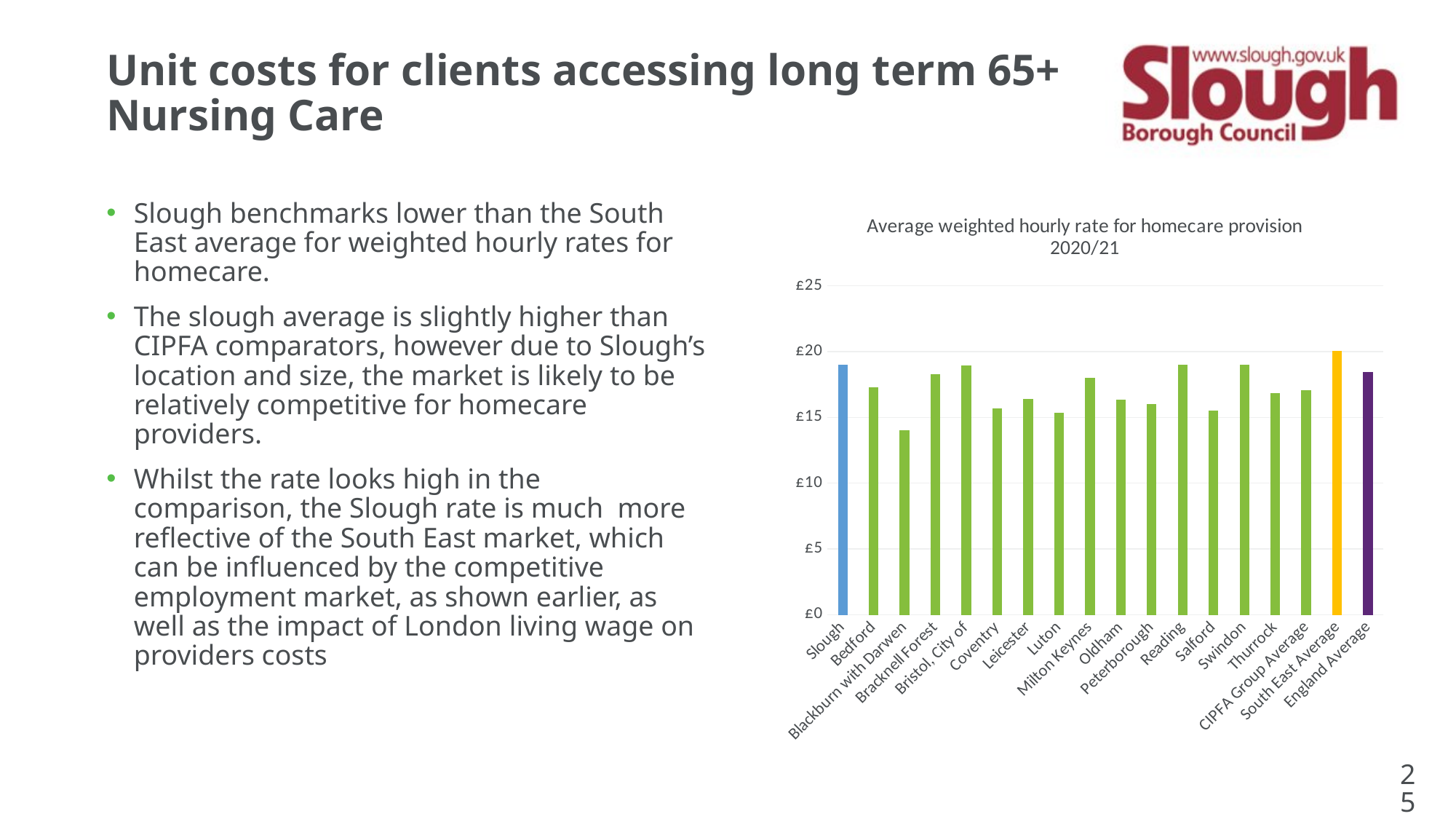
How many categories are plotted on the x axis of the chart? 18 Which is larger, the value for Slough or the value for Blackburn with Darwen? Slough Is the value for Slough greater or less than £15? greater Is the value for Luton greater or less than £20? less What kind of chart is shown on the slide? Bar chart Is the value for Blackburn with Darwen greater or less than £15? less Which category has the highest average weighted hourly rate? South East Average What is the title of the chart? Average weighted hourly rate for homecare provision 2020/21 What colour is the bar for Slough in the chart? Blue Which is larger, the value for Milton Keynes or the value for Coventry? Milton Keynes Which category has the lowest average weighted hourly rate? Blackburn with Darwen Which is larger, the value for Luton or the value for Bedford? Bedford